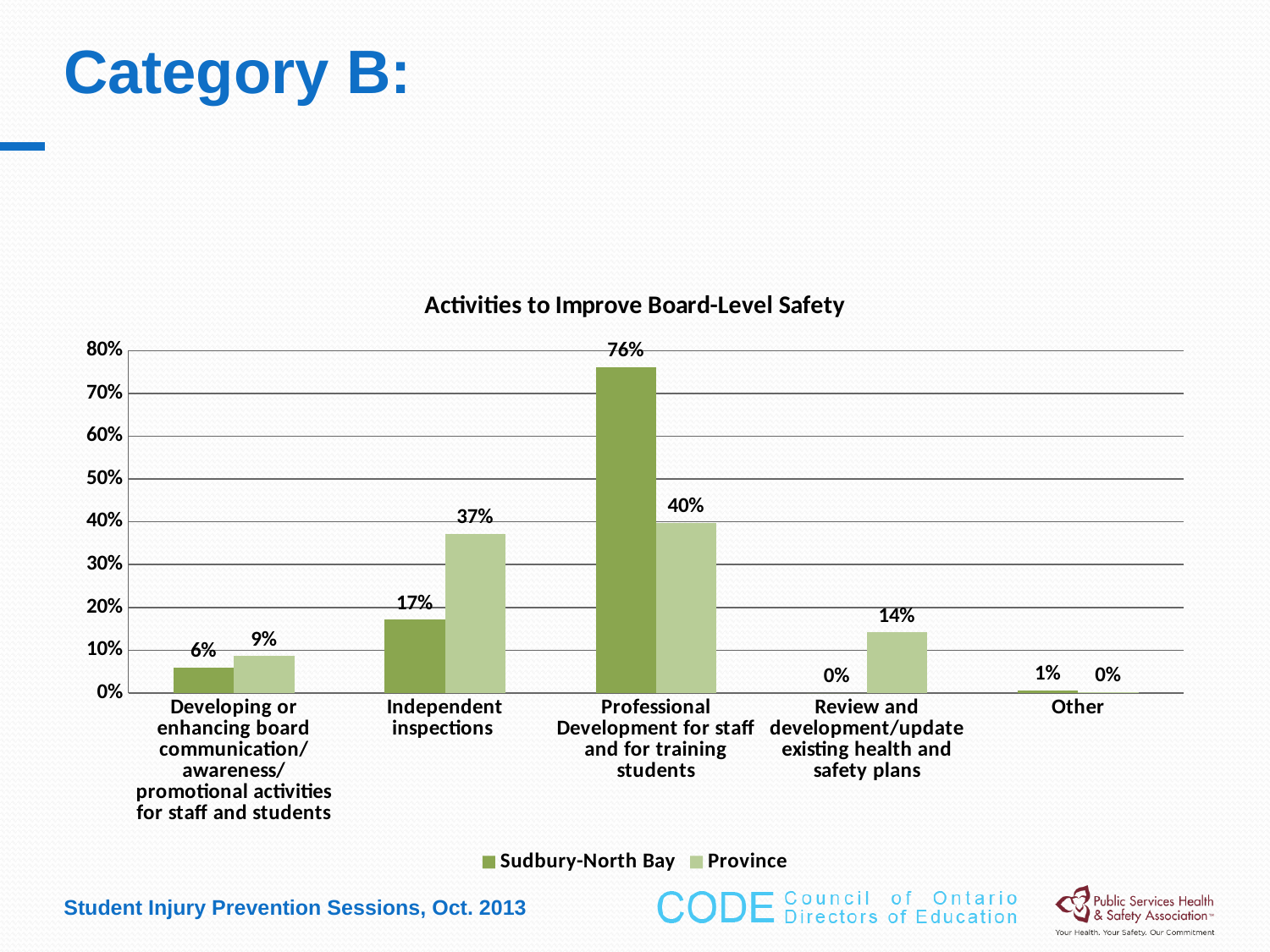
What kind of chart is shown on the slide? Bar chart How many categories are shown on the x axis? 5 What is the Sudbury-North Bay value for Other? 1% For Independent inspections, which series has the larger value, Sudbury-North Bay or Province? Province What is the difference between the Sudbury-North Bay and Province values for Professional Development for staff and for training students? 36% Which category has the highest Sudbury-North Bay value? Professional Development for staff and for training students What is the Sudbury-North Bay value for Professional Development for staff and for training students? 76% What is the Province value for Review and development/update existing health and safety plans? 14% Which category has the lowest Province value? Other What is the Province value for Independent inspections? 37% How many series does the legend list? 2 What is the title of the chart? Activities to Improve Board-Level Safety